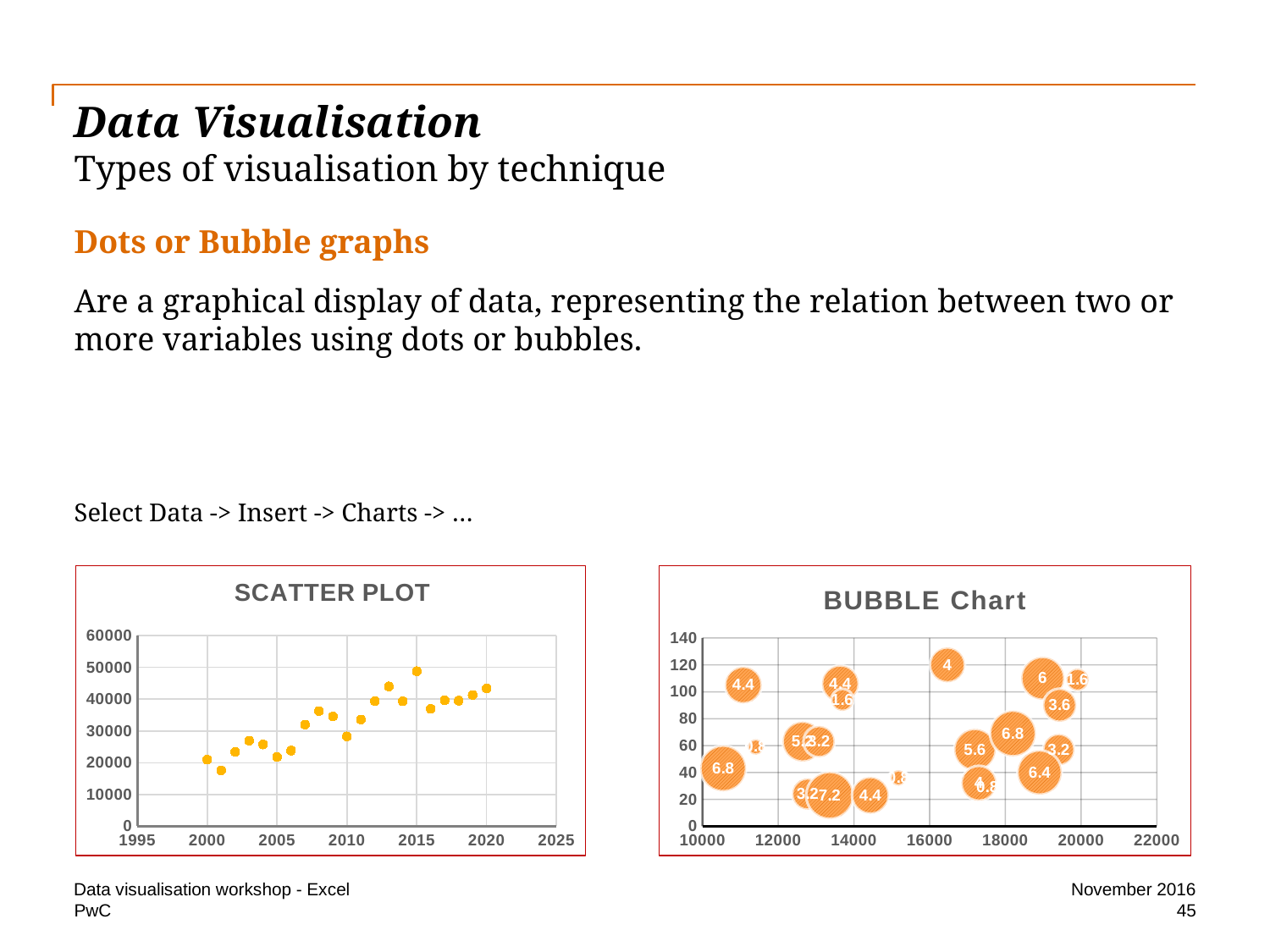
In the SCATTER PLOT chart, which year has the lowest value? 2001 In the SCATTER PLOT chart, do the values generally rise or fall as the years increase along the x axis? rise In the SCATTER PLOT chart, is the value for 2001 greater or less than 20000? less In the SCATTER PLOT chart, is the value for 2015 greater or less than 40000? greater What is the highest value shown on the x axis of the BUBBLE Chart? 22000 In the BUBBLE Chart, is the bubble labelled '5.6' positioned above or below 80 on the y axis? below In the SCATTER PLOT chart, which year has the highest value? 2015 In the SCATTER PLOT chart, which has the larger value, 2015 or 2010? 2015 What kind of chart is the right chart titled 'BUBBLE Chart'? bubble chart What kind of chart is the left chart titled 'SCATTER PLOT'? scatter plot